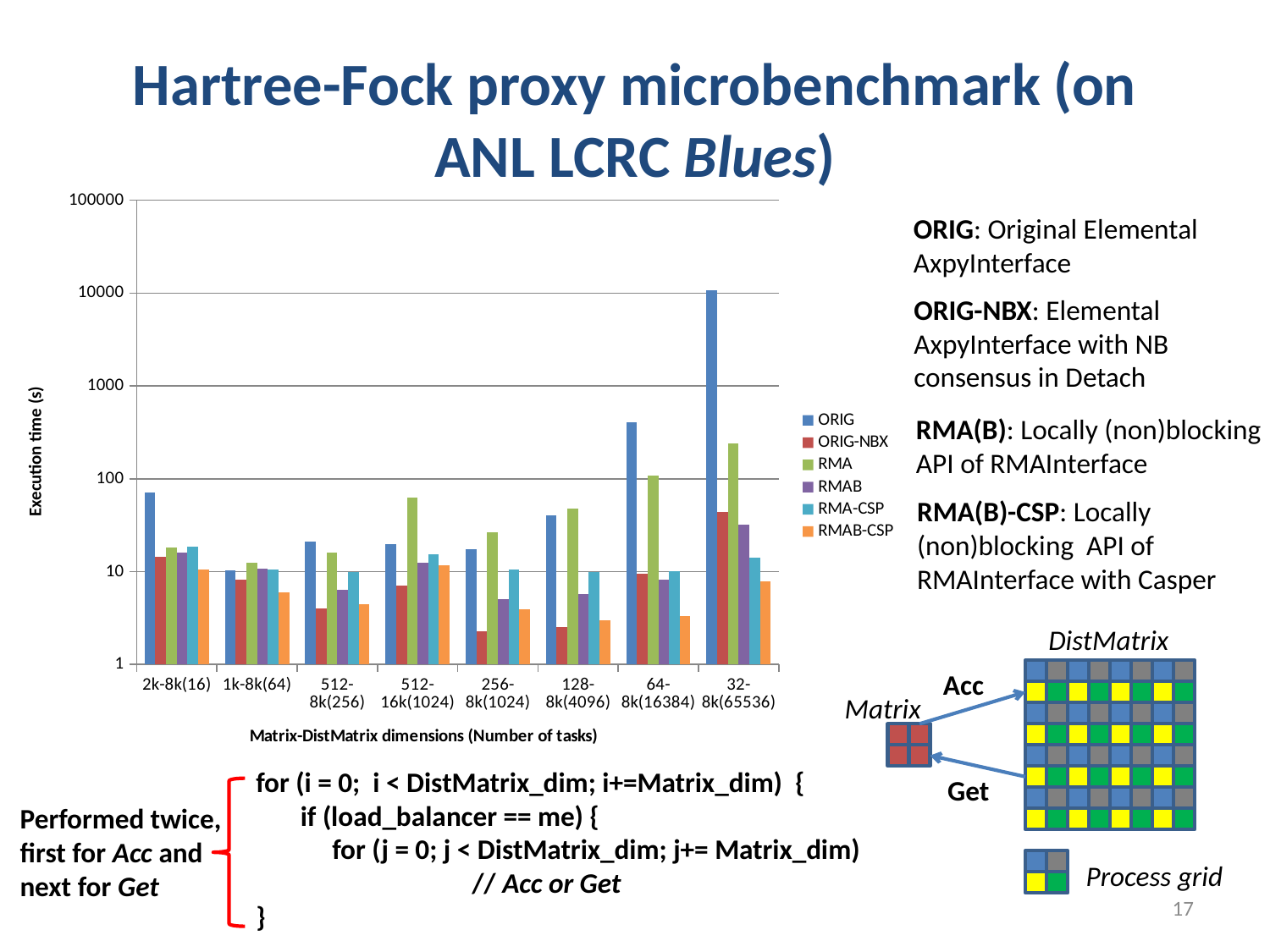
What is the label of the y axis of the chart? Execution time (s) How many series does the chart legend list? 6 Is the ORIG value for 32-8k(65536) greater or less than 1000? greater Is the ORIG-NBX value for 256-8k(1024) greater or less than 10? less For 512-16k(1024), which is larger, the ORIG value or the RMA value? RMA Which series has the highest value for 32-8k(65536)? ORIG What kind of chart is shown on the slide? bar chart For which category is the ORIG series highest? 32-8k(65536) How many categories are shown on the x axis of the chart? 8 Is the ORIG value for 64-8k(16384) greater or less than 100? greater What is the label of the x axis of the chart? Matrix-DistMatrix dimensions (Number of tasks)